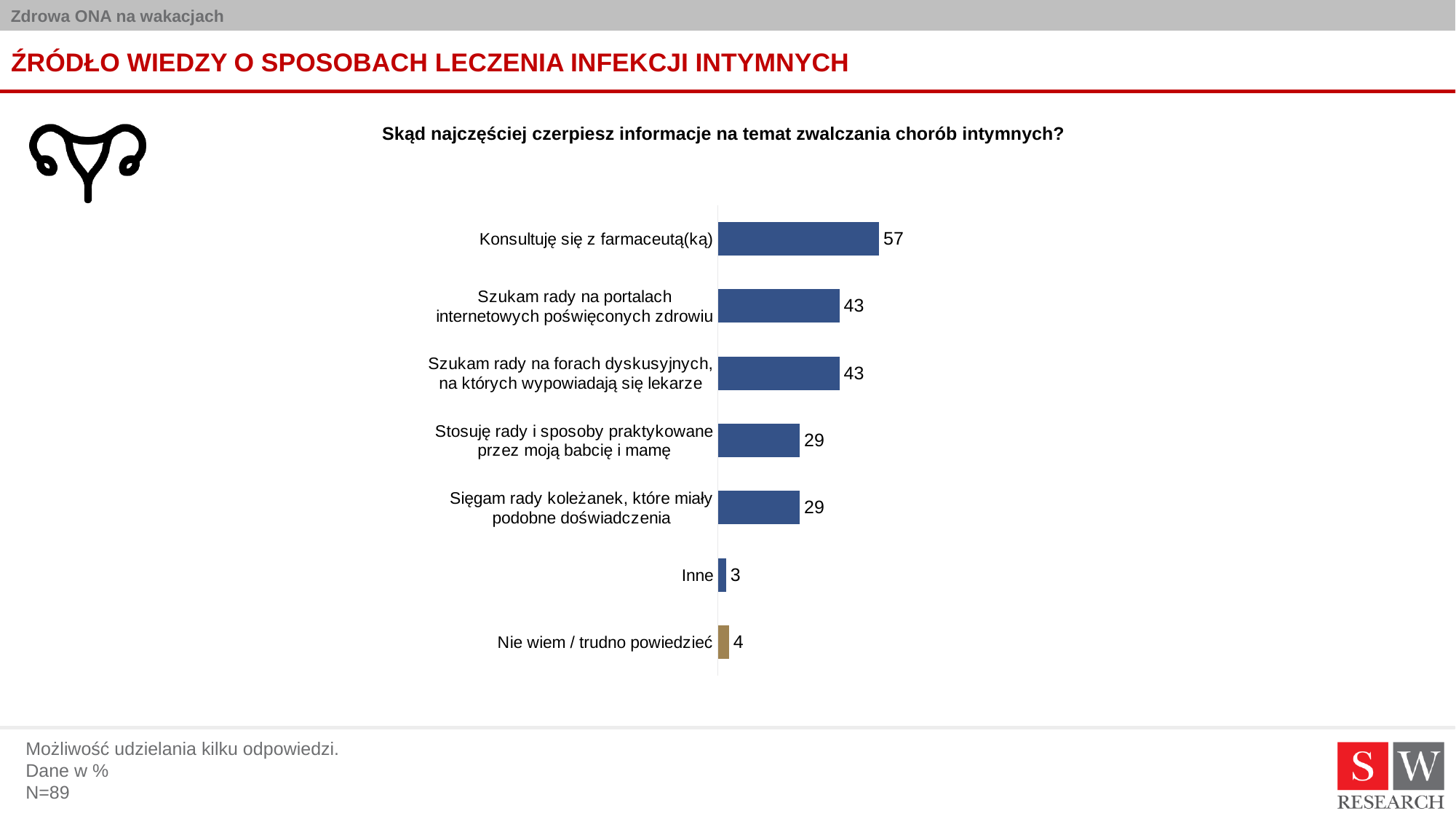
What value is shown for "Nie wiem / trudno powiedzieć"? 4 What value is shown for "Stosuję rady i sposoby praktykowane przez moją babcię i mamę"? 29 Which category has the highest value? Konsultuję się z farmaceutą(ką) How many categories are shown in the chart? 7 What kind of chart is shown on the slide? Bar chart What question is shown as the chart's title? Skąd najczęściej czerpiesz informacje na temat zwalczania chorób intymnych? What is the difference between the values for "Konsultuję się z farmaceutą(ką)" and "Szukam rady na portalach internetowych poświęconych zdrowiu"? 14 What value is shown for "Inne"? 3 What is the difference between the values for "Szukam rady na forach dyskusyjnych, na których wypowiadają się lekarze" and "Sięgam rady koleżanek, które miały podobne doświadczenia"? 14 Which is larger: the value for "Nie wiem / trudno powiedzieć" or the value for "Inne"? Nie wiem / trudno powiedzieć Which category has the lowest value? Inne What value is shown for "Konsultuję się z farmaceutą(ką)"? 57